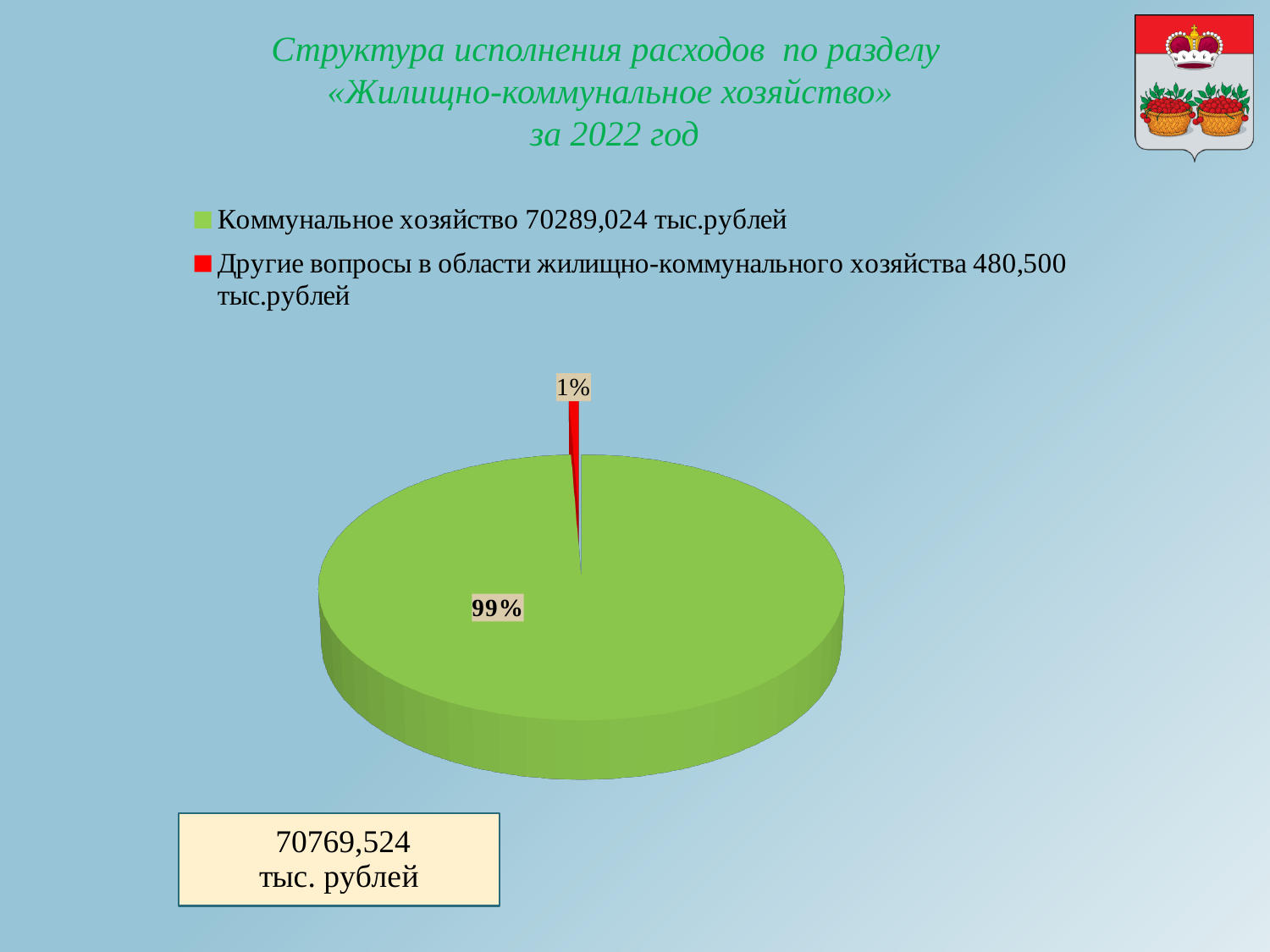
How many entries does the legend list? 2 What amount is given in the legend for «Коммунальное хозяйство»? 70289,024 тыс.рублей What is the difference in percentage points between the two slices of the pie? 98 How many slices does the pie chart have? 2 Which category has the largest share of the pie? Коммунальное хозяйство Which is larger: the share for «Коммунальное хозяйство» or for «Другие вопросы в области жилищно-коммунального хозяйства»? Коммунальное хозяйство Which category has the smallest share of the pie? Другие вопросы в области жилищно-коммунального хозяйства What share of the pie does «Другие вопросы в области жилищно-коммунального хозяйства» take? 1% What kind of chart is shown on the slide? pie chart What share of the pie does «Коммунальное хозяйство» take? 99% What amount is given in the legend for «Другие вопросы в области жилищно-коммунального хозяйства»? 480,500 тыс.рублей What colour is the slice for «Другие вопросы в области жилищно-коммунального хозяйства»? red